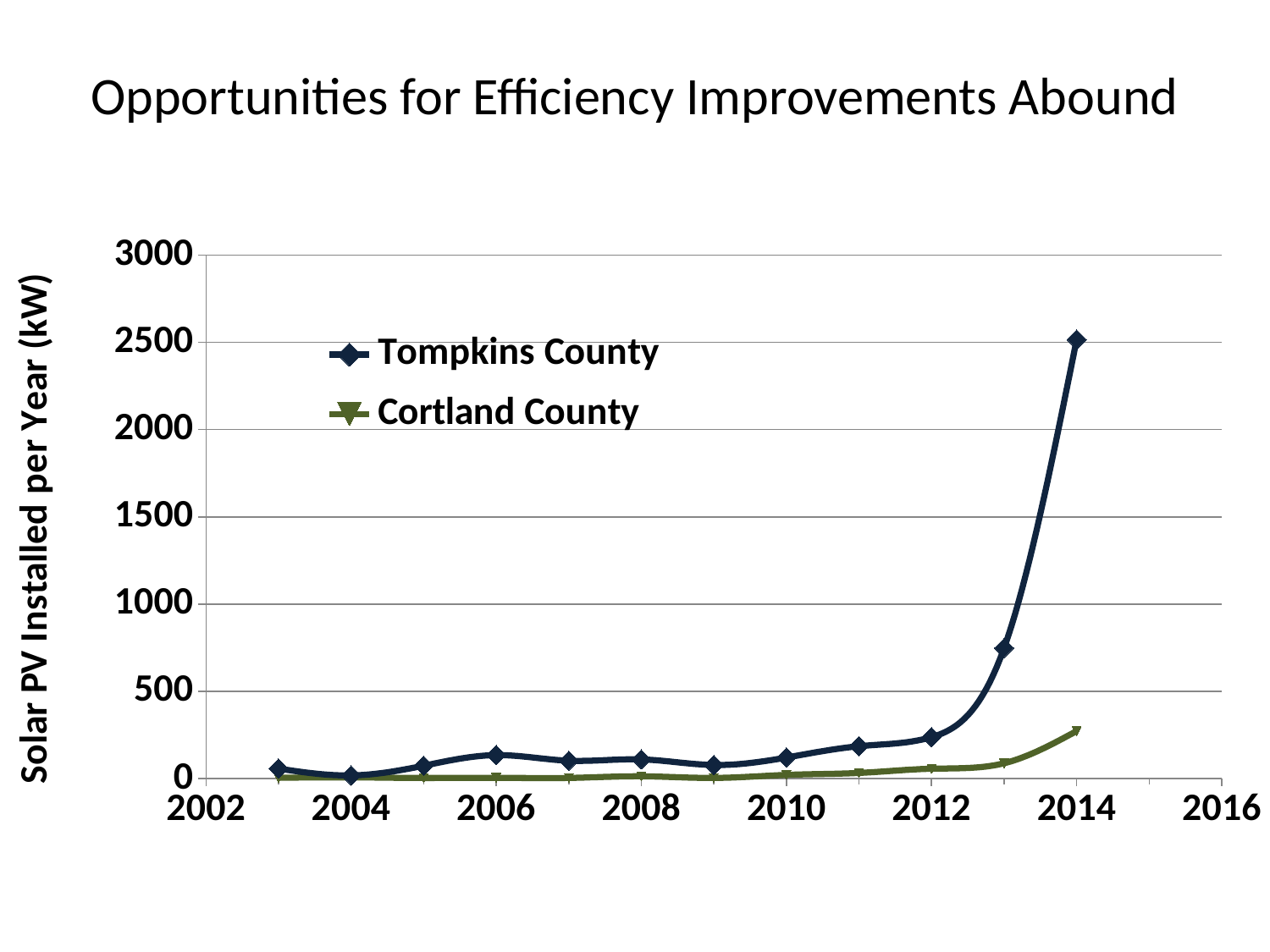
What kind of chart is shown on the slide? line chart In which year does the Tompkins County series reach its highest value? 2014 Is the Tompkins County value for 2014 greater or less than 2000? greater Is the Tompkins County value for 2013 greater or less than 1000? less Does the Tompkins County series rise or fall between 2012 and 2014? rise Is the Cortland County value for 2014 greater or less than 500? less What are the two series named in the legend? Tompkins County and Cortland County How many data points are plotted for the Tompkins County series? 12 Which series has the higher value in 2014, Tompkins County or Cortland County? Tompkins County What is the label of the vertical axis? Solar PV Installed per Year (kW) How many series does the legend list? 2